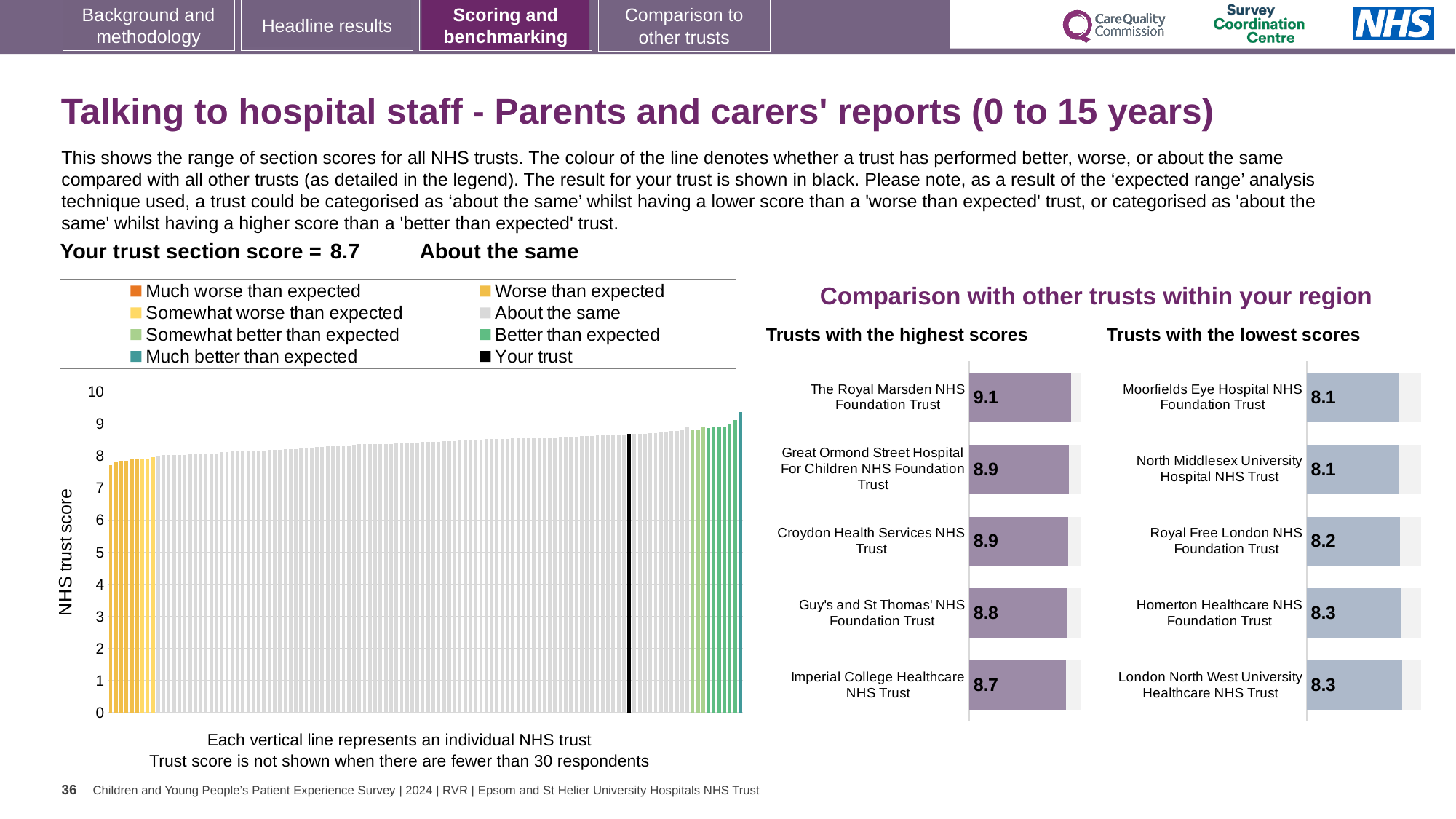
How many entries does the legend of the main chart on the left list? 8 In the 'Trusts with the highest scores' chart, what is the score for The Royal Marsden NHS Foundation Trust? 9.1 In the 'Trusts with the highest scores' chart, which trust has the lowest score? Imperial College Healthcare NHS Trust In the 'Trusts with the lowest scores' chart, how many trusts are shown? 5 What kind of chart is the main chart on the left showing all NHS trusts? Bar chart In the main chart on the left, is the value for your trust (the black bar) greater or less than 8? greater In the 'Trusts with the highest scores' chart, which trust has the highest score? The Royal Marsden NHS Foundation Trust In the 'Trusts with the highest scores' chart, how many trusts are shown? 5 In the main chart on the left showing all NHS trusts, what is the section score for your trust? 8.7 In the 'Trusts with the lowest scores' chart, what is the score for Royal Free London NHS Foundation Trust? 8.2 In the 'Trusts with the highest scores' chart, what is the difference between the scores of The Royal Marsden NHS Foundation Trust and Imperial College Healthcare NHS Trust? 0.4 In the 'Trusts with the lowest scores' chart, which has the larger score: Homerton Healthcare NHS Foundation Trust or Moorfields Eye Hospital NHS Foundation Trust? Homerton Healthcare NHS Foundation Trust